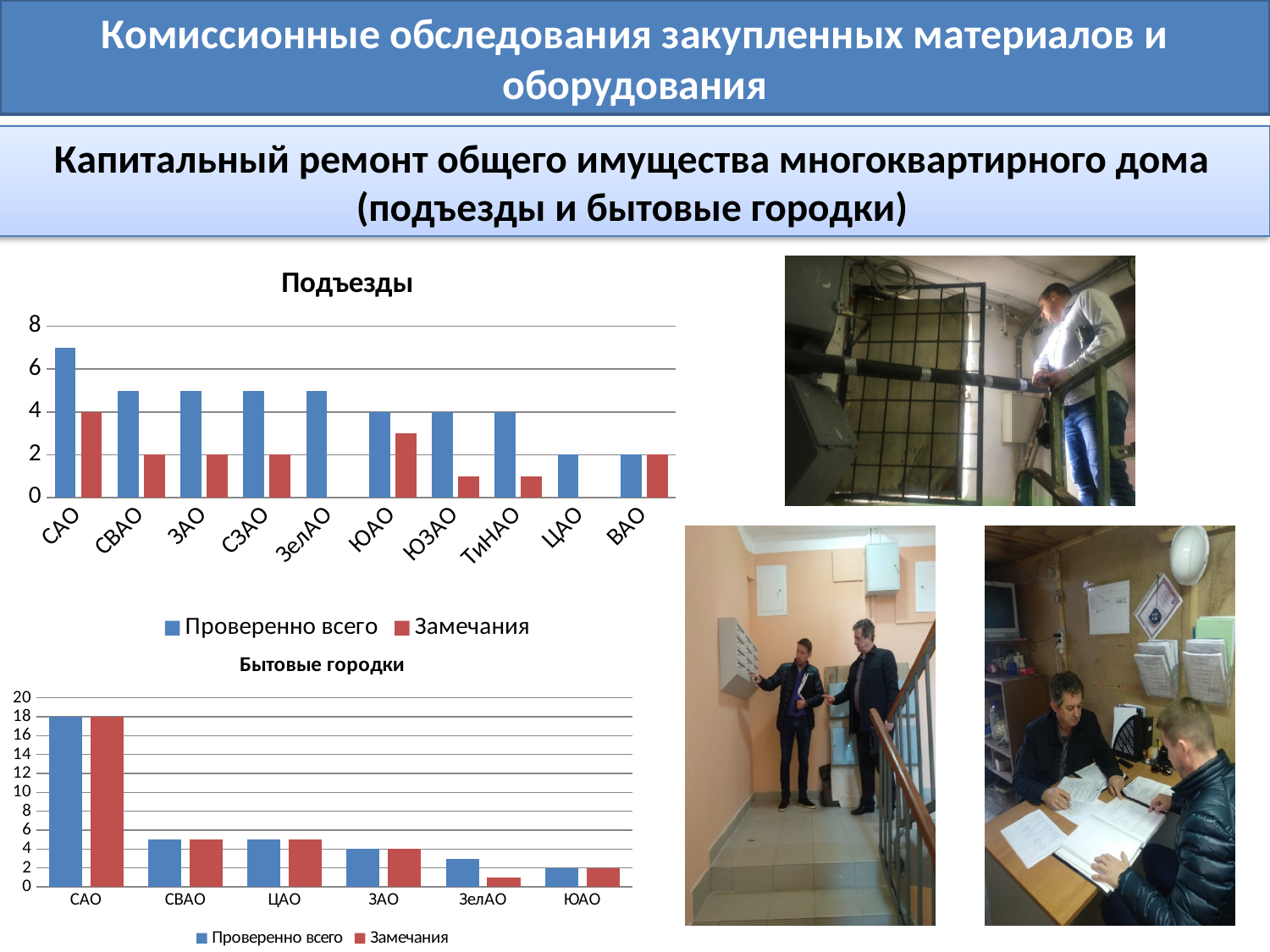
How many categories are shown on the x axis of the "Подъезды" chart? 10 In the "Бытовые городки" chart, is the value of "Проверенно всего" for СВАО greater or less than 4? greater In the "Бытовые городки" chart, what is the value of "Проверенно всего" for САО? 18 In the "Подъезды" chart, which category has the highest value for "Проверенно всего"? САО In the "Подъезды" chart, is the value of "Проверенно всего" for САО greater or less than 6? greater In the "Подъезды" chart, what is the value of "Проверенно всего" for ЦАО? 2 How many series does the legend of the "Подъезды" chart list? 2 How many categories are shown on the x axis of the "Бытовые городки" chart? 6 In the "Бытовые городки" chart, which category has the highest value for "Замечания"? САО In the "Бытовые городки" chart, which is larger for ЗелАО: "Проверенно всего" or "Замечания"? Проверенно всего What kind of chart is the "Подъезды" chart? bar chart In the "Подъезды" chart, what is the value of "Замечания" for САО? 4